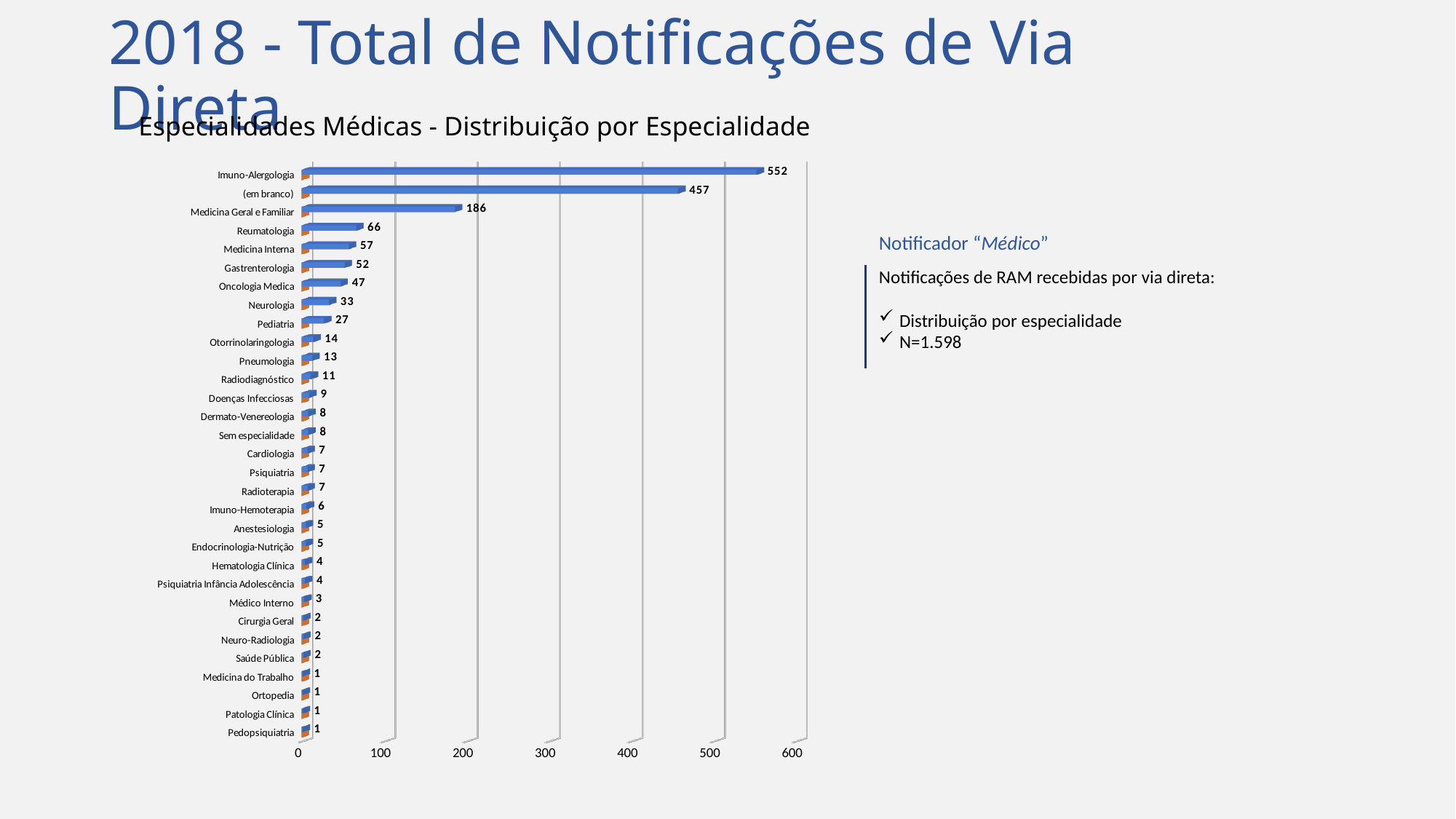
Which is larger, the value for Gastrenterologia or the value for Oncologia Medica? Gastrenterologia What is the value for Neurologia? 33 Is the value for (em branco) greater or less than 400? greater Which category has the highest value? Imuno-Alergologia What is the value for Medicina Geral e Familiar? 186 What is the difference between the values for Reumatologia and Medicina Interna? 9 What is the title of the chart? Especialidades Médicas - Distribuição por Especialidade What is the value for Pneumologia? 13 How many categories are shown on the chart? 31 What kind of chart is shown on the slide? bar chart What is the difference between the values for Imuno-Alergologia and (em branco)? 95 What is the value for Imuno-Alergologia? 552